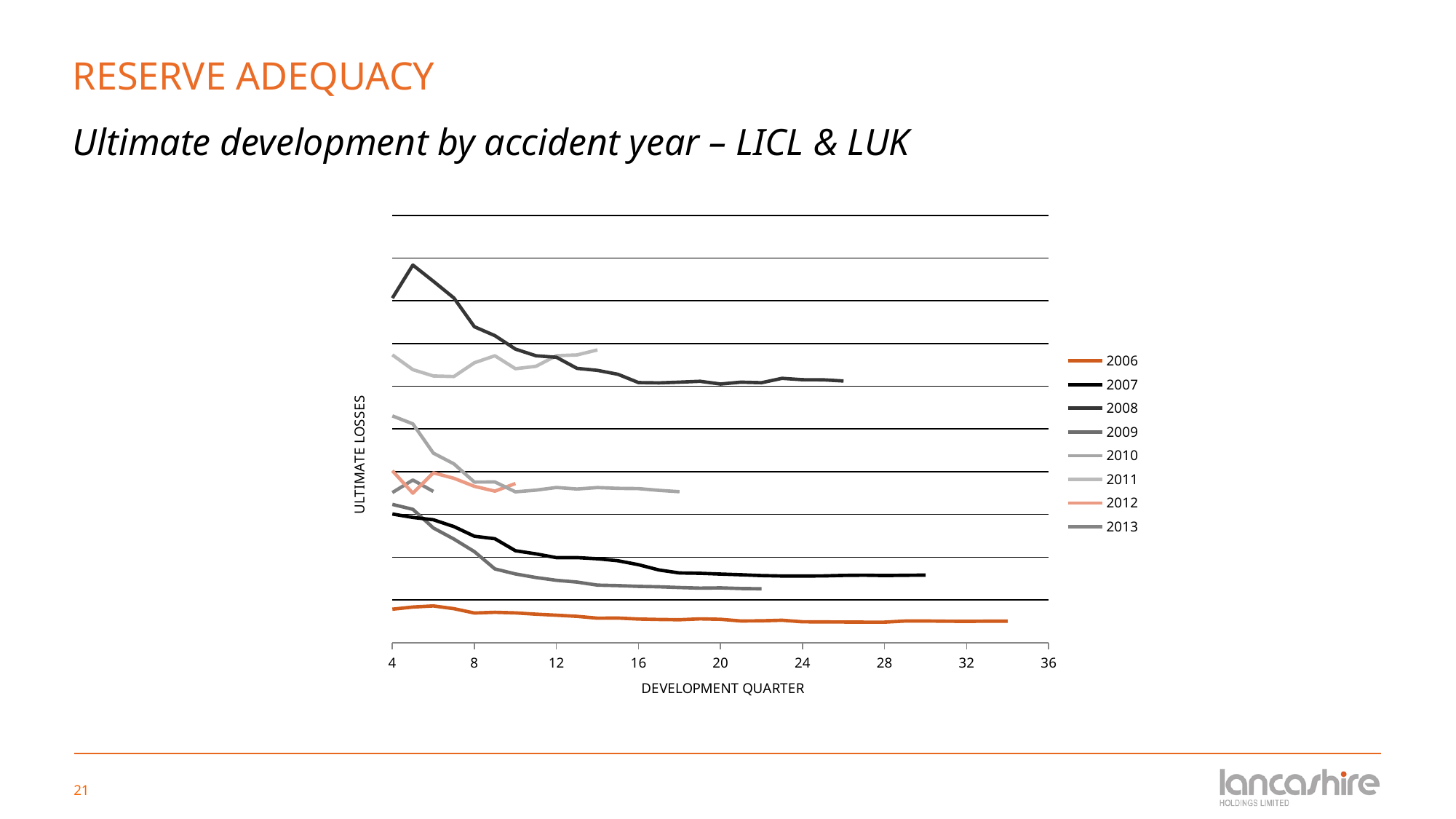
Which accident year series has the lowest ultimate losses across the chart? 2006 What is the last development quarter labelled on the horizontal axis? 36 Do the ultimate losses for the 2008 series rise or fall as the development quarter increases? fall Do the ultimate losses for the 2007 series rise or fall as the development quarter increases? fall Which accident year series reaches the highest ultimate losses on the chart? 2008 Which series is higher on the chart, 2007 or 2006? 2007 How many series does the legend list? 8 What is the title of the chart's vertical axis? ULTIMATE LOSSES Which series extends to the highest development quarter on the chart? 2006 Which series is higher on the chart, 2008 or 2009? 2008 What kind of chart is shown on the slide? line chart What is the title of the chart's horizontal axis? DEVELOPMENT QUARTER